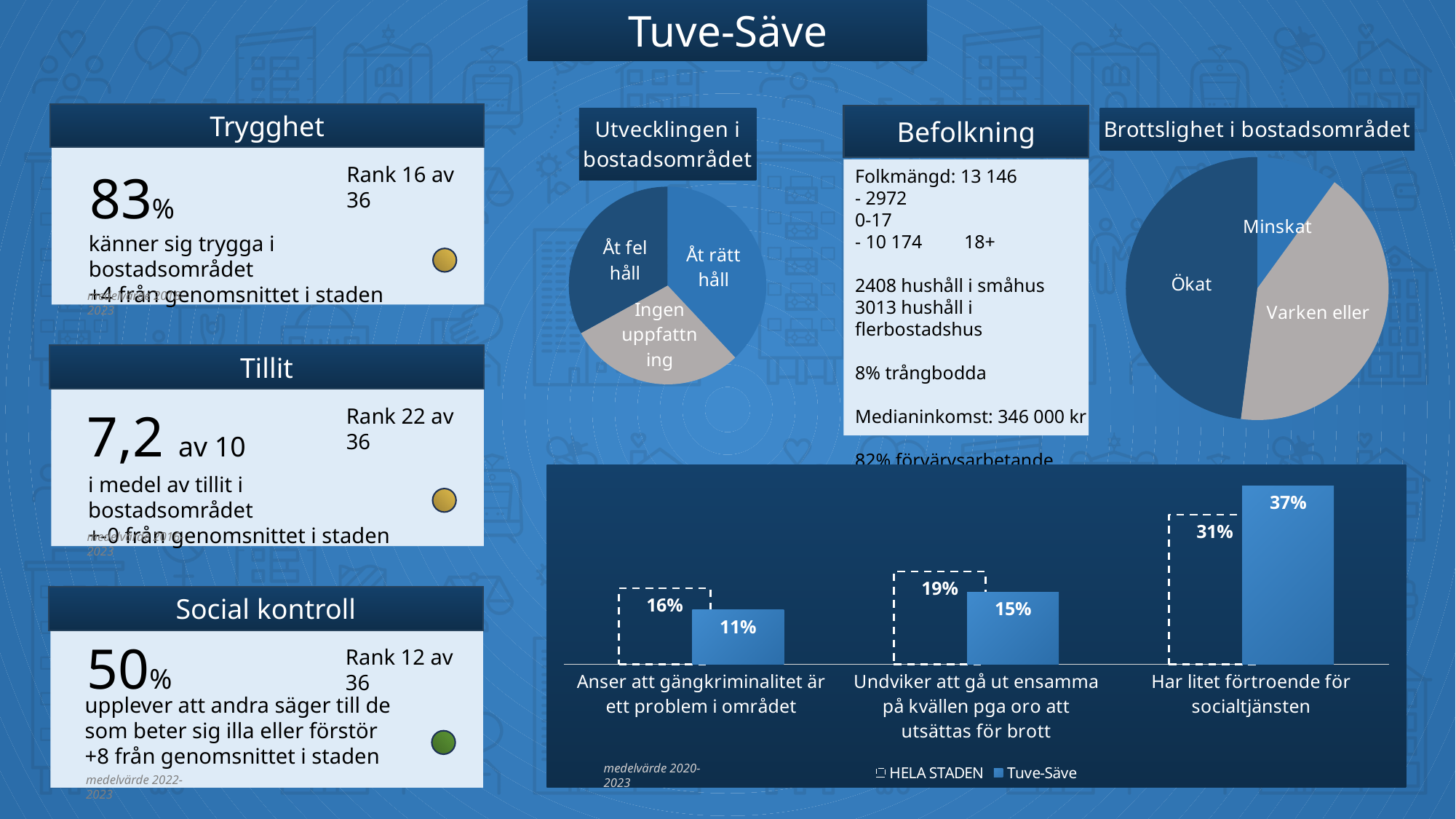
In the bar chart at the bottom, how many categories are shown on the x axis? 3 In the bar chart at the bottom, which category has the lowest HELA STADEN value? Anser att gängkriminalitet är ett problem i området In the bar chart at the bottom, what is the Tuve-Säve value for 'Har litet förtroende för socialtjänsten'? 37% What kind of chart is the chart titled 'Brottslighet i bostadsområdet'? Pie chart In the bar chart at the bottom, how many series does the legend list? 2 How many slices does the pie chart titled 'Utvecklingen i bostadsområdet' have? 3 In the bar chart at the bottom, for 'Undviker att gå ut ensamma på kvällen pga oro att utsättas för brott', which is larger: HELA STADEN or Tuve-Säve? HELA STADEN In the bar chart at the bottom, what is the HELA STADEN value for 'Anser att gängkriminalitet är ett problem i området'? 16% In the bar chart at the bottom, what is the difference between the Tuve-Säve and HELA STADEN values for 'Har litet förtroende för socialtjänsten'? 6% In the pie chart titled 'Brottslighet i bostadsområdet', which slice is the largest? Ökat In the bar chart at the bottom, which category has the highest Tuve-Säve value? Har litet förtroende för socialtjänsten In the bar chart at the bottom, what is the Tuve-Säve value for 'Undviker att gå ut ensamma på kvällen pga oro att utsättas för brott'? 15%